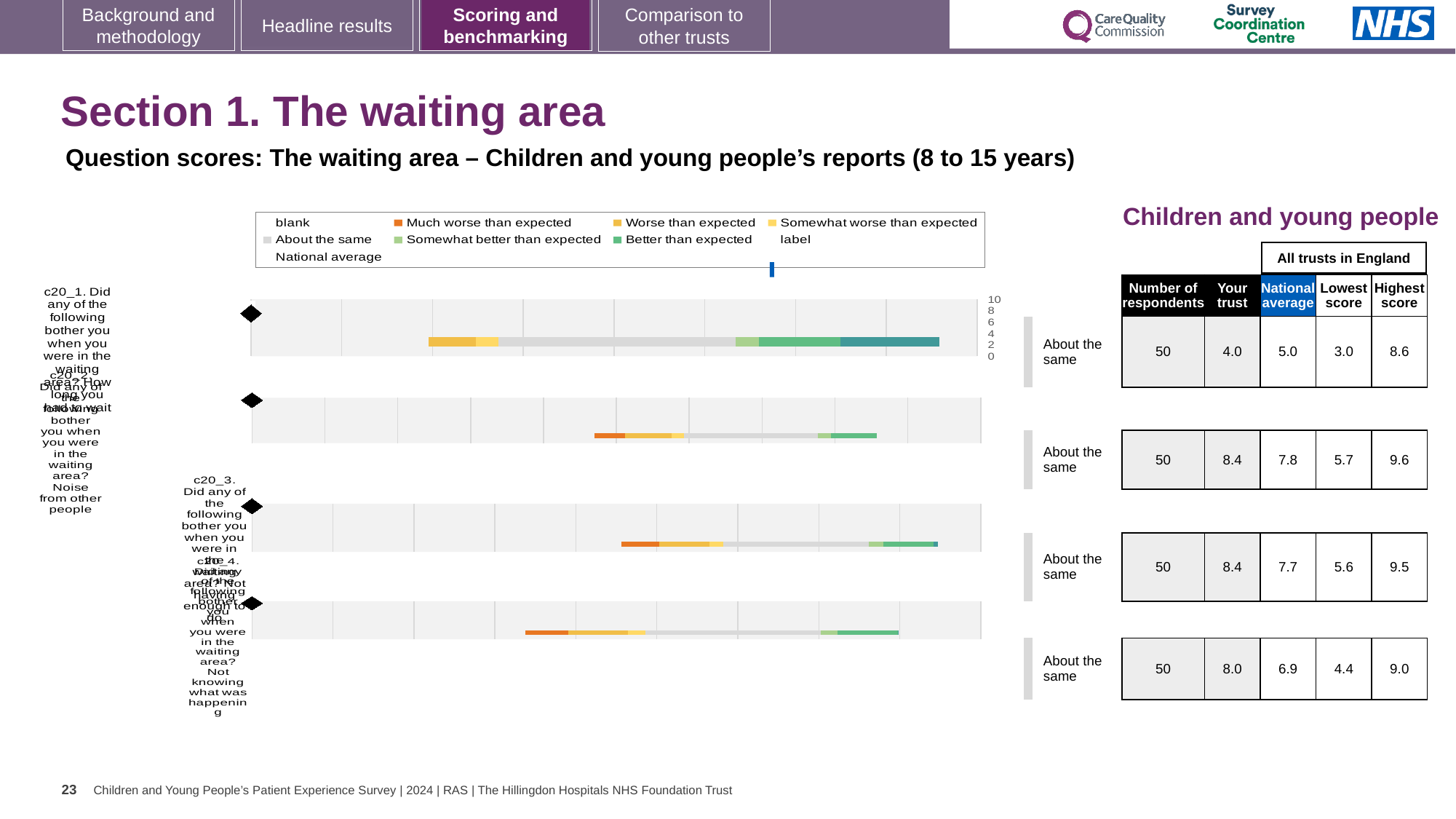
What colour is used in the legend for 'Much worse than expected'? orange What benchmark rating is shown next to each of the four bars? About the same How many horizontal bars (questions) are plotted in the chart? 4 For the second question row, which is larger: the 'Your trust' score or the national average? Your trust What is the difference between the highest score (8.6) and the lowest score (3.0) for the first question row? 5.6 In the table beside the chart, what is the 'Your trust' score for the first question (c20_1)? 4.0 What is the highest score across all trusts in England for the fourth question row? 9.0 How many respondents are listed for each question in the table? 50 In the table beside the chart, what is the national average for the first question (c20_1)? 5.0 For the second question row, what is the difference between the 'Your trust' score (8.4) and the national average (7.8)? 0.6 What kind of chart is shown on the slide? bar chart Which question row has the lowest 'Your trust' score in the table? c20_1